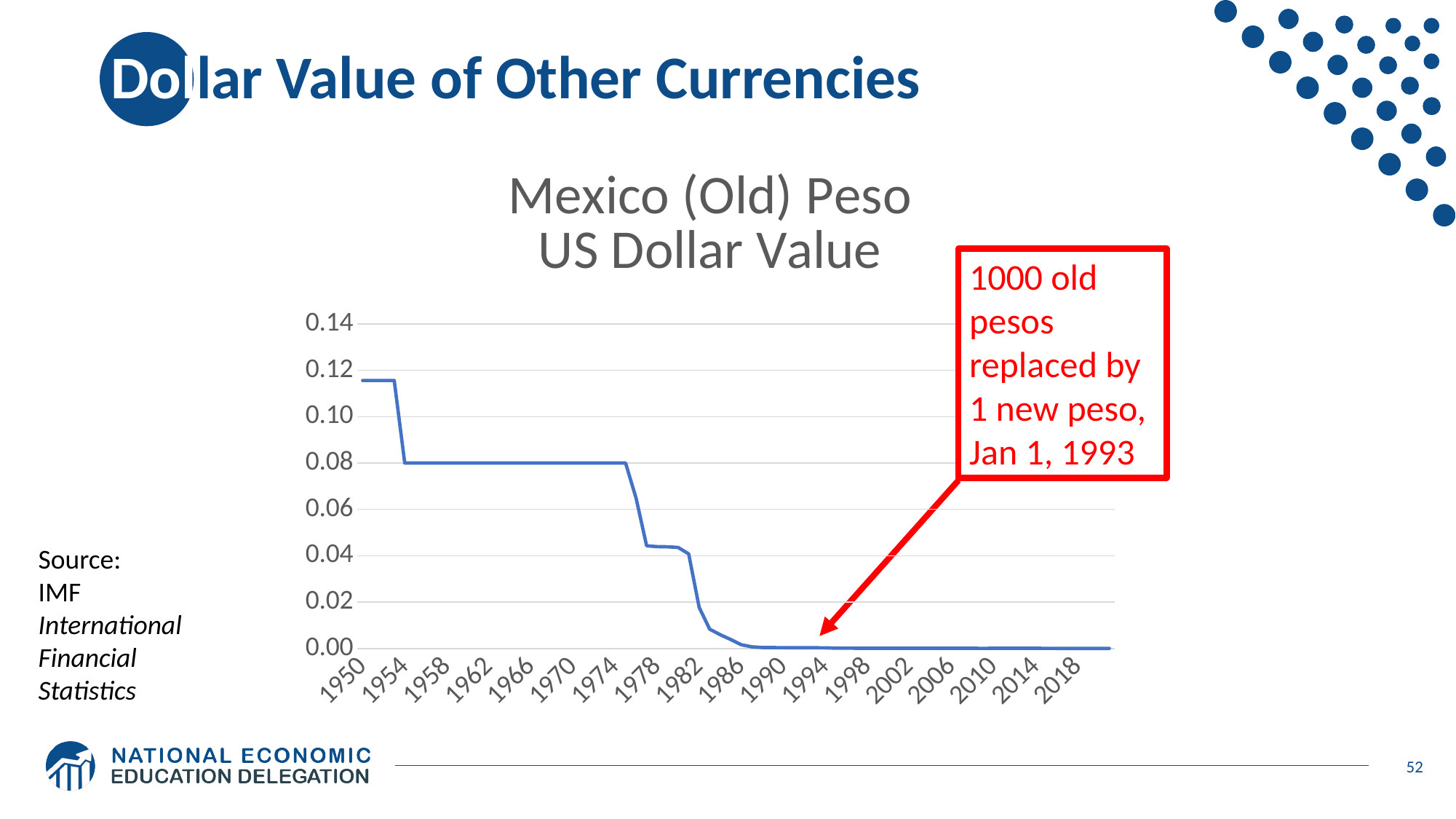
According to the annotation, on what date were 1000 old pesos replaced by 1 new peso? Jan 1, 1993 How many year labels are shown on the x axis? 18 In which labeled year is the US dollar value of the old peso highest? 1950 Does the US dollar value of the Mexican old peso rise or fall from 1950 to 2018? fall Which year has the highest US dollar value of the old peso, 1950 or 1982? 1950 What is the title of the chart? Mexico (Old) Peso US Dollar Value What kind of chart is shown on the slide? line chart Is the value for 1966 greater or less than 0.06? greater Is the value for 1978 greater or less than 0.06? less Is the value for 1990 greater or less than 0.02? less What is the US dollar value of the old peso in 1966? 0.08